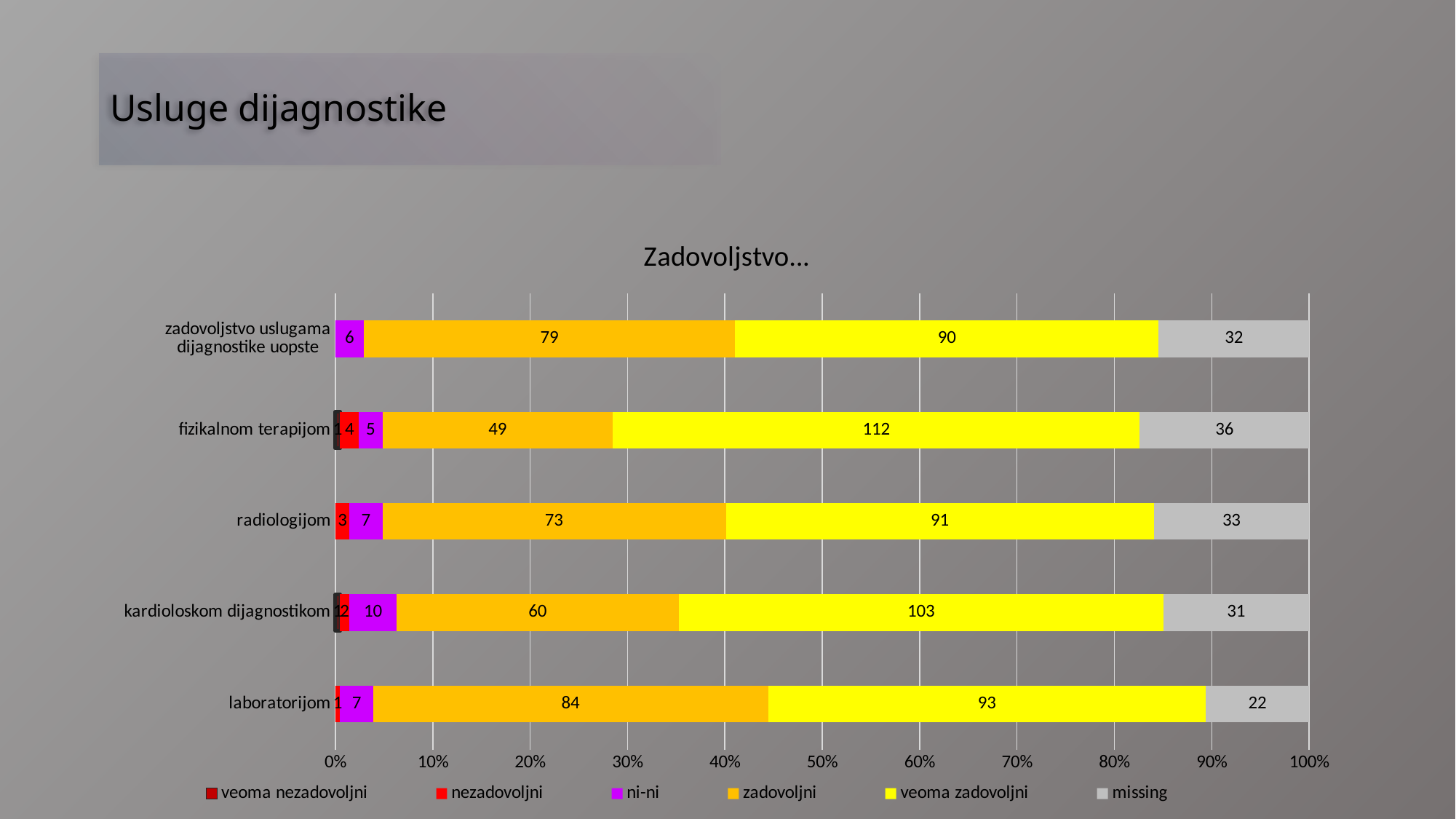
How many categories are plotted on the y axis of the chart? 5 What is the 'zadovoljni' value for 'radiologijom'? 73 What is the 'missing' value for 'laboratorijom'? 22 Which category has the lowest 'missing' value? laboratorijom What is the difference between the 'zadovoljni' values for 'zadovoljstvo uslugama dijagnostike uopste' and 'fizikalnom terapijom'? 30 How many series does the legend list? 6 Which has the larger 'veoma zadovoljni' value: 'kardioloskom dijagnostikom' or 'radiologijom'? kardioloskom dijagnostikom What is the 'veoma zadovoljni' value for 'fizikalnom terapijom'? 112 What is the title of the chart? Zadovoljstvo... Which category has the highest 'veoma zadovoljni' value? fizikalnom terapijom What kind of chart is shown on the slide? Stacked bar chart What is the total of all labelled segments in the 'radiologijom' bar? 207